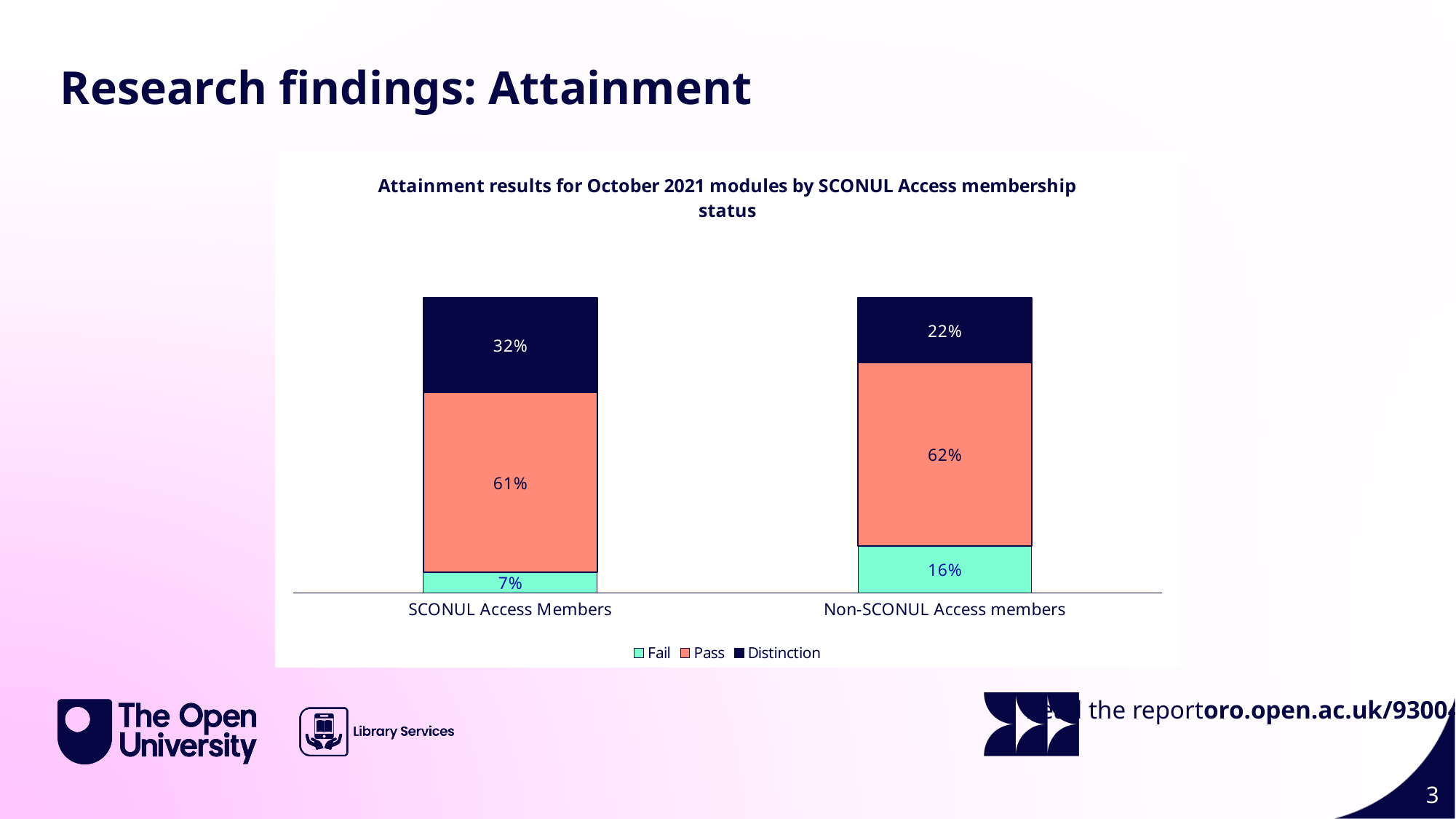
What is the difference in Fail percentage between Non-SCONUL Access members and SCONUL Access Members? 9% What is the Distinction percentage for SCONUL Access Members? 32% What is the Pass percentage for Non-SCONUL Access members? 62% How many series does the legend list? 3 What is the Fail percentage for SCONUL Access Members? 7% How many categories are shown on the x axis? 2 What kind of chart is shown on the slide? Stacked bar chart What is the difference in Distinction percentage between SCONUL Access Members and Non-SCONUL Access members? 10% What is the title of the chart? Attainment results for October 2021 modules by SCONUL Access membership status What is the Fail percentage for Non-SCONUL Access members? 16% Which group has the higher Distinction percentage? SCONUL Access Members Which group has the higher Fail percentage? Non-SCONUL Access members